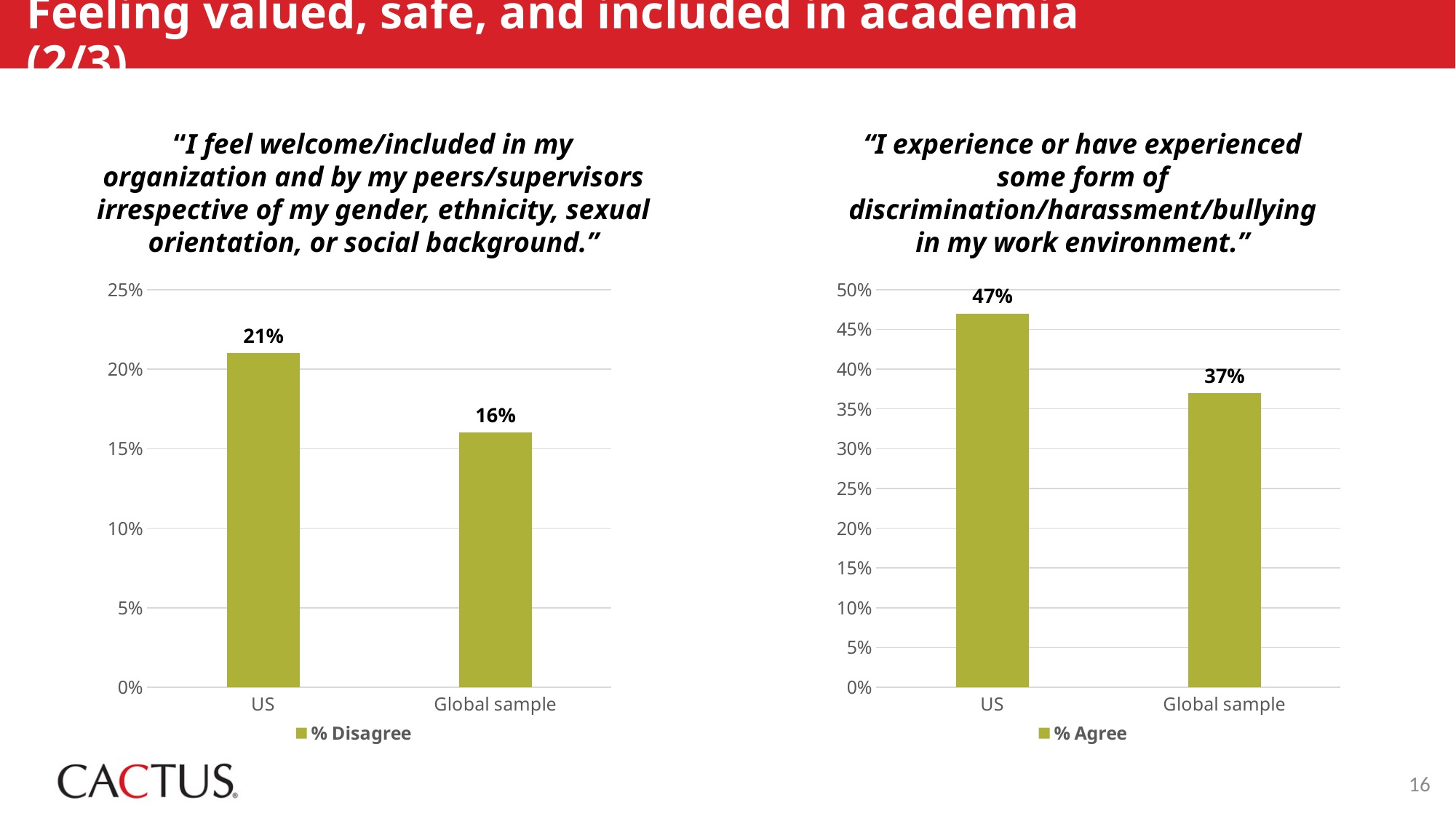
In the left chart ("I feel welcome/included in my organization..."), what is the % Disagree value for US? 21% In the right chart, what is the difference in percentage points between the US and Global sample values? 10 percentage points In the right chart ("I experience or have experienced some form of discrimination..."), what is the % Agree value for US? 47% In the right chart, which category has the lower % Agree value? Global sample In the left chart ("I feel welcome/included in my organization..."), what is the % Disagree value for the Global sample? 16% In the right chart ("I experience or have experienced some form of discrimination..."), what is the % Agree value for the Global sample? 37% What type of chart is used on the right side of the slide? Bar chart In the left chart, which category has the higher % Disagree value? US What is the legend entry for the series in the right chart? % Agree How many categories are shown on the x axis of the left chart? 2 In the right chart, is the US value greater or less than 45%? greater In the left chart, what is the difference in percentage points between the US and Global sample values? 5 percentage points